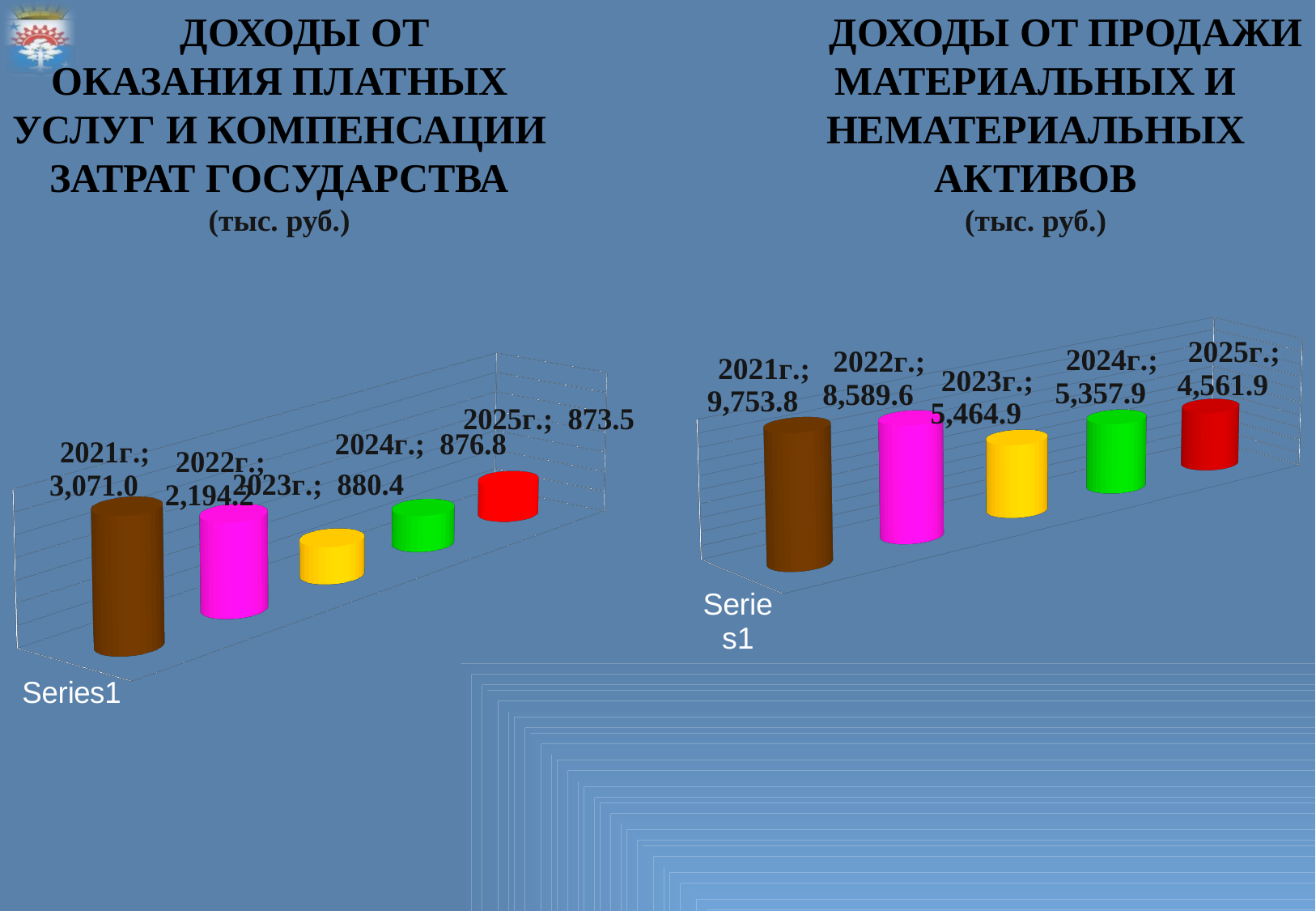
In the left chart (ДОХОДЫ ОТ ОКАЗАНИЯ ПЛАТНЫХ УСЛУГ), which year has the highest value? 2021г. In the right chart (ДОХОДЫ ОТ ПРОДАЖИ МАТЕРИАЛЬНЫХ И НЕМАТЕРИАЛЬНЫХ АКТИВОВ), what is the difference between the 2021г. and 2022г. values? 1,164.2 In the right chart (ДОХОДЫ ОТ ПРОДАЖИ МАТЕРИАЛЬНЫХ И НЕМАТЕРИАЛЬНЫХ АКТИВОВ), which year has the lowest value? 2025г. In the left chart (ДОХОДЫ ОТ ОКАЗАНИЯ ПЛАТНЫХ УСЛУГ И КОМПЕНСАЦИИ ЗАТРАТ ГОСУДАРСТВА), what is the value for 2021г.? 3,071.0 In the left chart (ДОХОДЫ ОТ ОКАЗАНИЯ ПЛАТНЫХ УСЛУГ), do the values rise or fall from 2021г. to 2025г.? fall In the right chart (ДОХОДЫ ОТ ПРОДАЖИ МАТЕРИАЛЬНЫХ И НЕМАТЕРИАЛЬНЫХ АКТИВОВ), which is larger, the value for 2022г. or the value for 2024г.? 2022г. What kind of chart is the left chart (ДОХОДЫ ОТ ОКАЗАНИЯ ПЛАТНЫХ УСЛУГ)? bar chart In the left chart (ДОХОДЫ ОТ ОКАЗАНИЯ ПЛАТНЫХ УСЛУГ), what is the difference between the 2021г. and 2022г. values? 876.8 In the right chart (ДОХОДЫ ОТ ПРОДАЖИ МАТЕРИАЛЬНЫХ И НЕМАТЕРИАЛЬНЫХ АКТИВОВ), what is the value for 2025г.? 4,561.9 How many years are plotted in the right chart (ДОХОДЫ ОТ ПРОДАЖИ МАТЕРИАЛЬНЫХ И НЕМАТЕРИАЛЬНЫХ АКТИВОВ)? 5 In the right chart (ДОХОДЫ ОТ ПРОДАЖИ МАТЕРИАЛЬНЫХ И НЕМАТЕРИАЛЬНЫХ АКТИВОВ), what is the value for 2023г.? 5,464.9 In the left chart (ДОХОДЫ ОТ ОКАЗАНИЯ ПЛАТНЫХ УСЛУГ), what is the value for 2025г.? 873.5